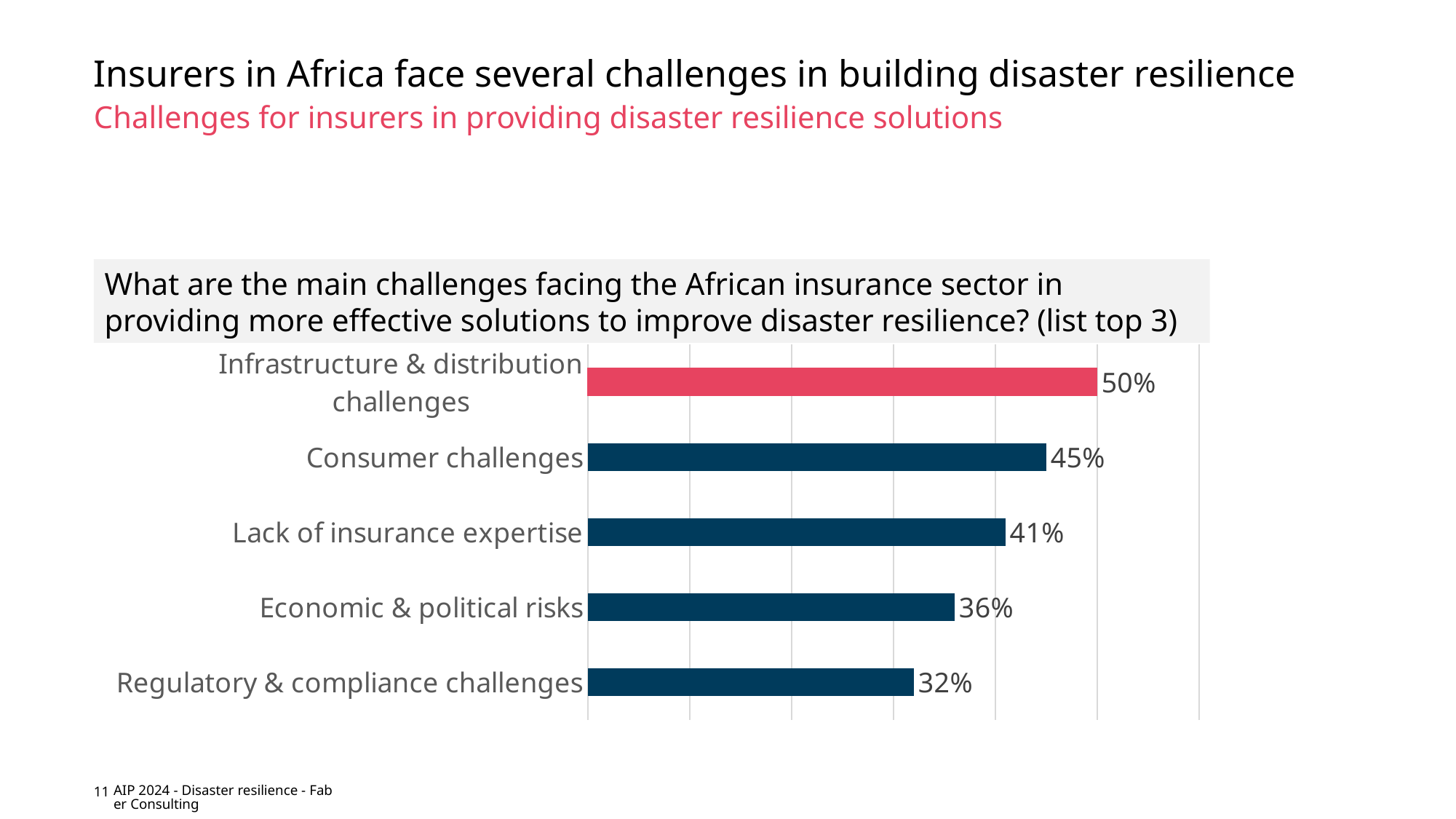
Which challenge has the highest value? Infrastructure & distribution challenges How many challenges are shown in the chart? 5 Which is larger: Lack of insurance expertise or Economic & political risks? Lack of insurance expertise What is the value for Lack of insurance expertise? 41% What is the difference between Consumer challenges and Economic & political risks? 9% What is the difference between Infrastructure & distribution challenges and Regulatory & compliance challenges? 18% Which challenge has the lowest value? Regulatory & compliance challenges Which bar is highlighted in a different colour (red) from the others? Infrastructure & distribution challenges What is the value for Regulatory & compliance challenges? 32% What is the value for Consumer challenges? 45% What kind of chart is shown on the slide? Bar chart What percentage of respondents cited Infrastructure & distribution challenges? 50%